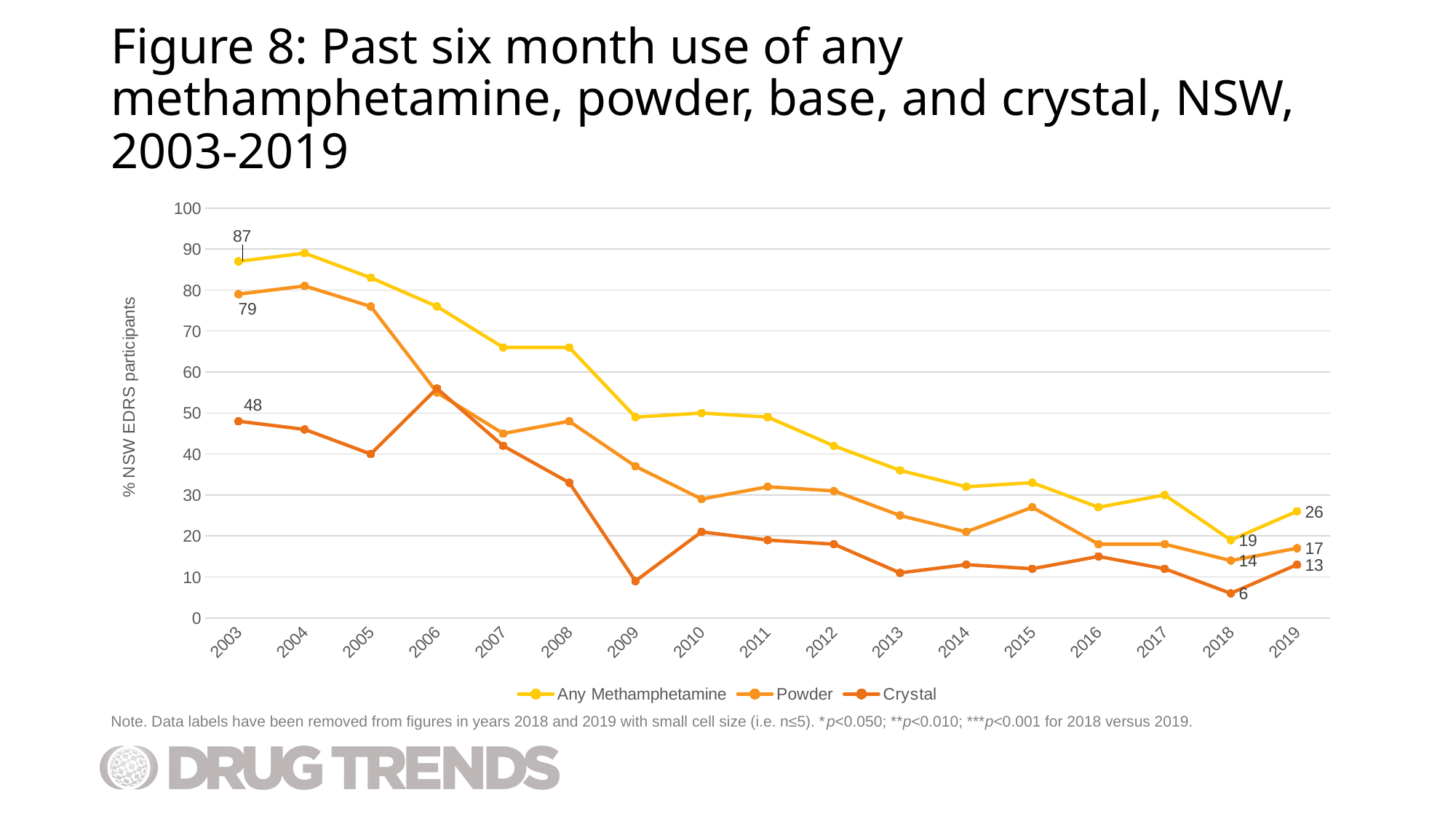
What is the value for Crystal in 2018? 6 What is the value for Any Methamphetamine in 2003? 87 What type of chart is shown on the slide? line chart What is the value for Powder in 2003? 79 How many years are shown on the x axis? 17 Does the Any Methamphetamine series generally rise or fall from 2003 to 2019? fall What is the value for Crystal in 2019? 13 How many series does the legend list? 3 What is the difference between the Powder and Crystal values in 2019? 4 Is the value for Any Methamphetamine in 2010 greater or less than 40? greater What is the difference between the Any Methamphetamine values in 2003 and 2019? 61 In which year is the Crystal series at its lowest? 2018